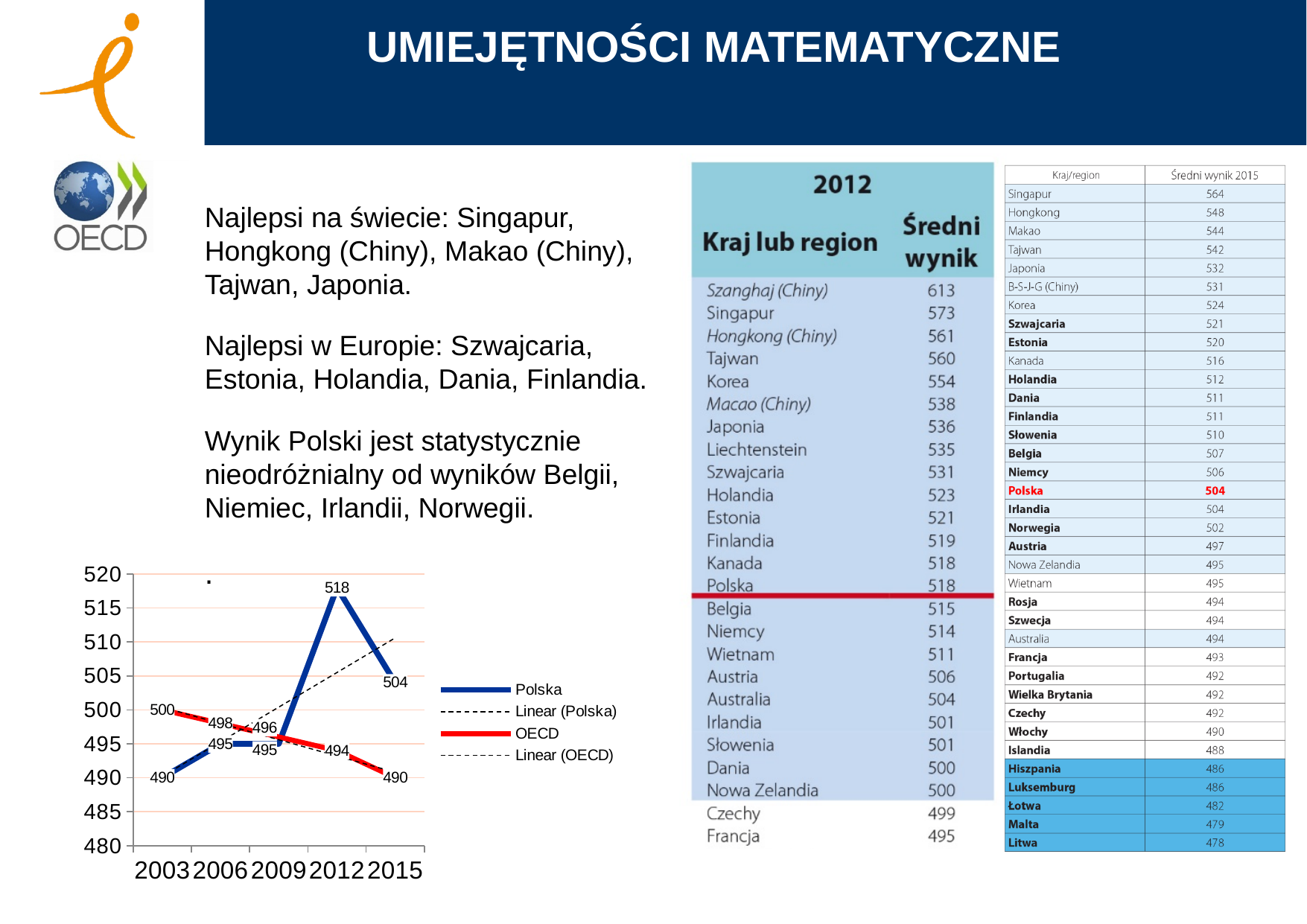
How many entries does the legend of the line chart list? 4 What is the difference between the Polska and OECD values in 2012 on the line chart? 24 How many years are shown on the x axis of the line chart? 5 What is the value for Polska in 2015 on the line chart? 504 In which year does the Polska series reach its highest value on the line chart? 2012 Does the OECD series rise or fall from 2003 to 2015 on the line chart? fall In 2003, which is larger on the line chart: Polska or OECD? OECD What is the value for Polska in 2012 on the line chart? 518 What is the value for OECD in 2015 on the line chart? 490 What is the value for OECD in 2003 on the line chart? 500 In which year is the Polska series lowest on the line chart? 2003 What type of chart is shown at the bottom left of the slide? line chart